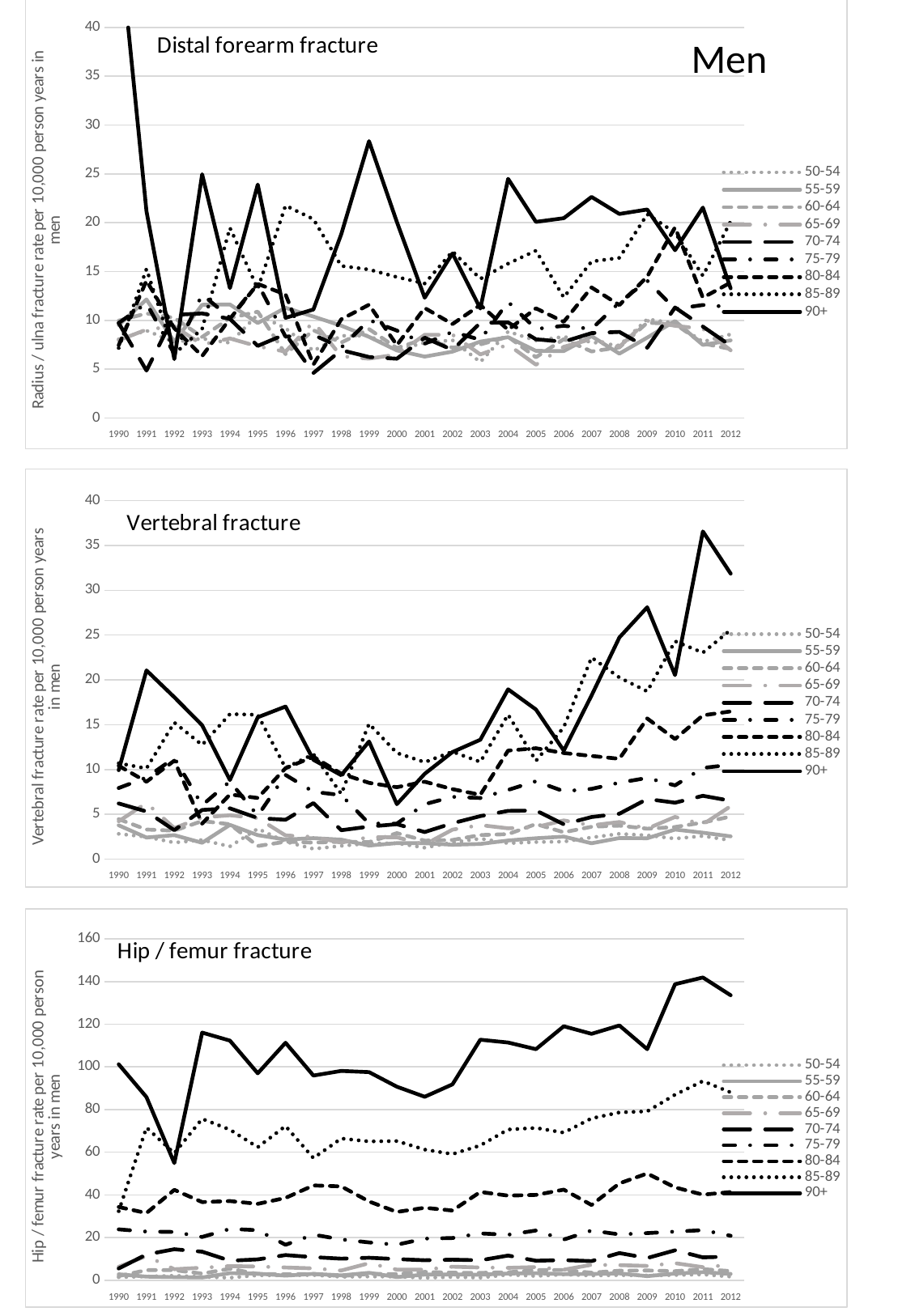
In the 'Hip / femur fracture' chart, does the 90+ line rise or fall from 2009 to 2011? rise In the 'Hip / femur fracture' chart, is the value for the 90+ group in 2011 greater or less than 120? greater What is the highest value shown on the y axis of the 'Hip / femur fracture' chart? 160 In the 'Hip / femur fracture' chart, which age group has the highest fracture rate across the years shown? 90+ What kind of chart is the 'Distal forearm fracture' chart? line chart In the 'Distal forearm fracture' chart, is the value for the 90+ group in 1990 greater or less than 35? greater In the 'Vertebral fracture' chart, is the value for the 90+ group in 2011 greater or less than 30? greater How many series does the legend of the 'Vertebral fracture' chart list? 9 In the 'Hip / femur fracture' chart, which is larger in 2012: the 90+ group or the 85-89 group? 90+ How many years are shown on the x axis of the 'Hip / femur fracture' chart? 23